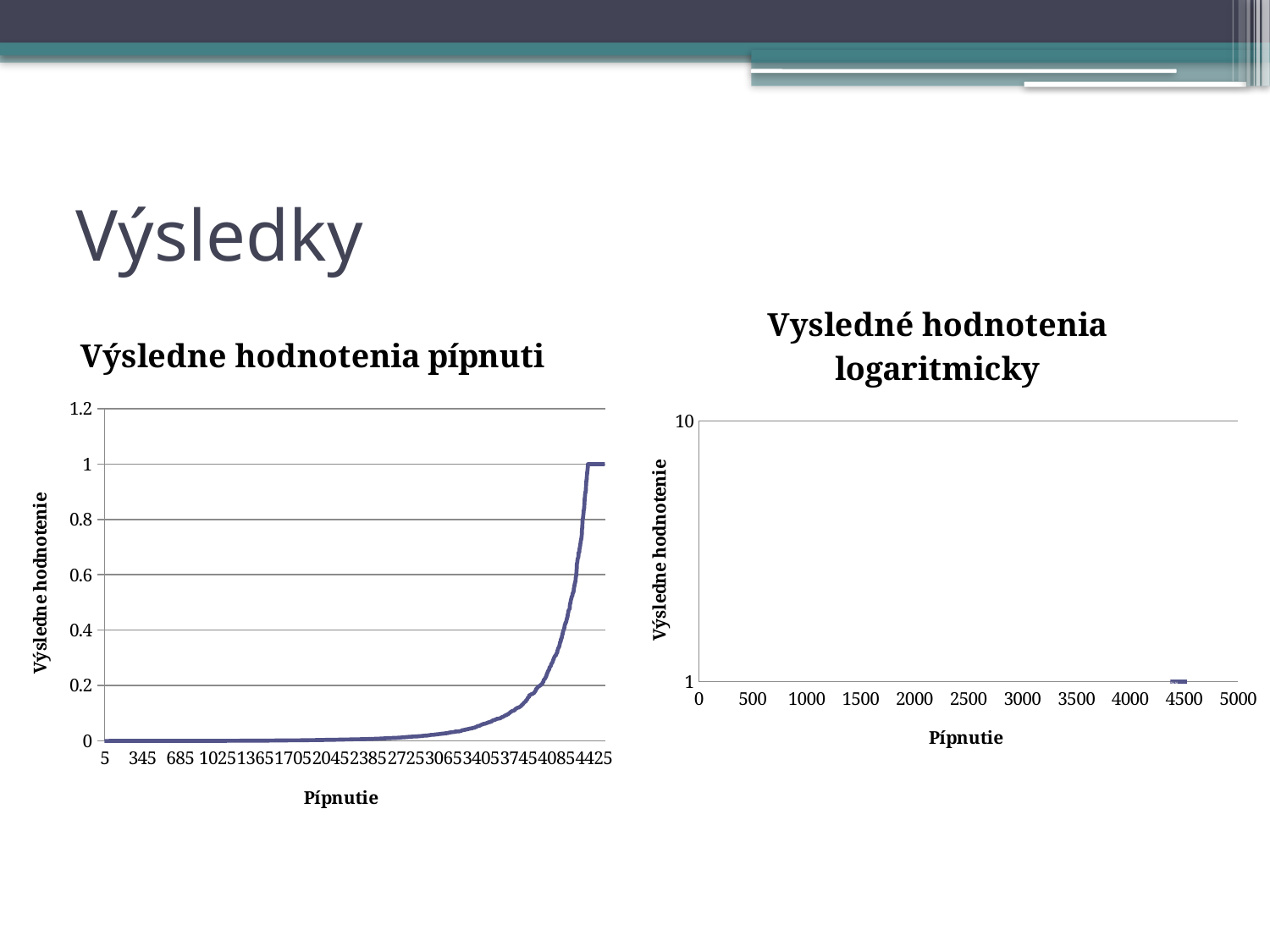
What is the title of the right chart on the slide? Vysledné hodnotenia logaritmicky What is the highest tick value shown on the y axis of the left chart 'Výsledne hodnotenia pípnuti'? 1.2 What is the highest tick value shown on the y axis of the right chart 'Vysledné hodnotenia logaritmicky'? 10 What kind of chart is the left chart titled 'Výsledne hodnotenia pípnuti'? line chart In the left chart 'Výsledne hodnotenia pípnuti', is the value at x = 3405 greater or less than 0.2? less In the left chart 'Výsledne hodnotenia pípnuti', is the value at the first x-axis label (5) greater or less than 0.2? less In the left chart 'Výsledne hodnotenia pípnuti', is the value at the last x-axis label (4425) greater or less than 0.8? greater In the left chart 'Výsledne hodnotenia pípnuti', do the values rise or fall along the x axis? rise In the left chart 'Výsledne hodnotenia pípnuti', which is larger: the value at x = 2045 or the value at x = 4085? 4085